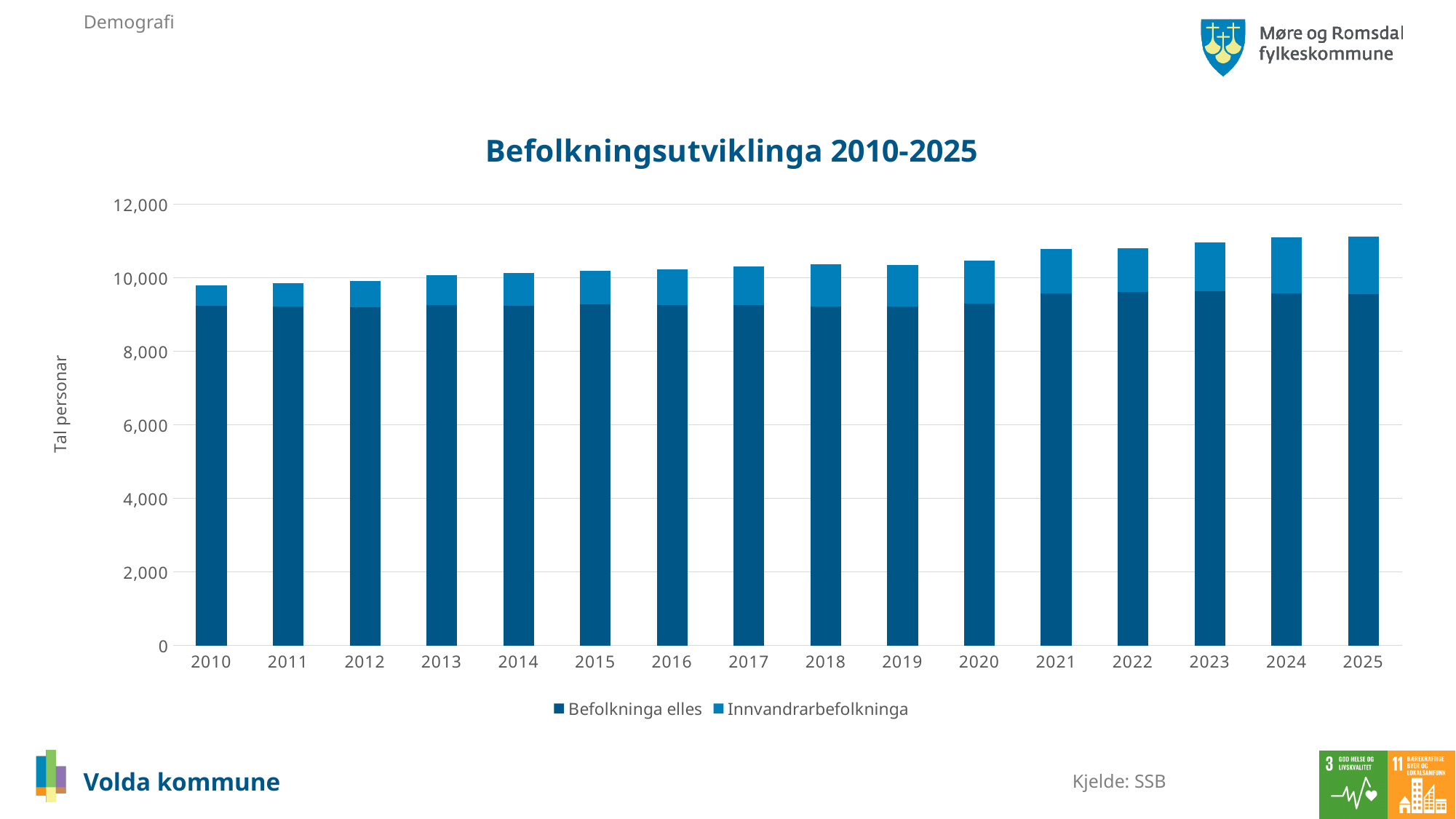
Is the value for Befolkninga elles in 2010 greater or less than 8,000? greater How many years are shown on the x axis? 16 Which series is larger in 2020, Befolkninga elles or Innvandrarbefolkninga? Befolkninga elles Which year has the larger total bar, 2010 or 2025? 2025 Is the total bar height for 2010 greater or less than 10,000? less Is the total bar height for 2025 greater or less than 10,000? greater What kind of chart is shown on the slide? Stacked bar chart Does the total population rise or fall from 2010 to 2025? Rises What is the label on the vertical axis? Tal personar What is the title of the chart? Befolkningsutviklinga 2010-2025 How many series does the legend list? 2